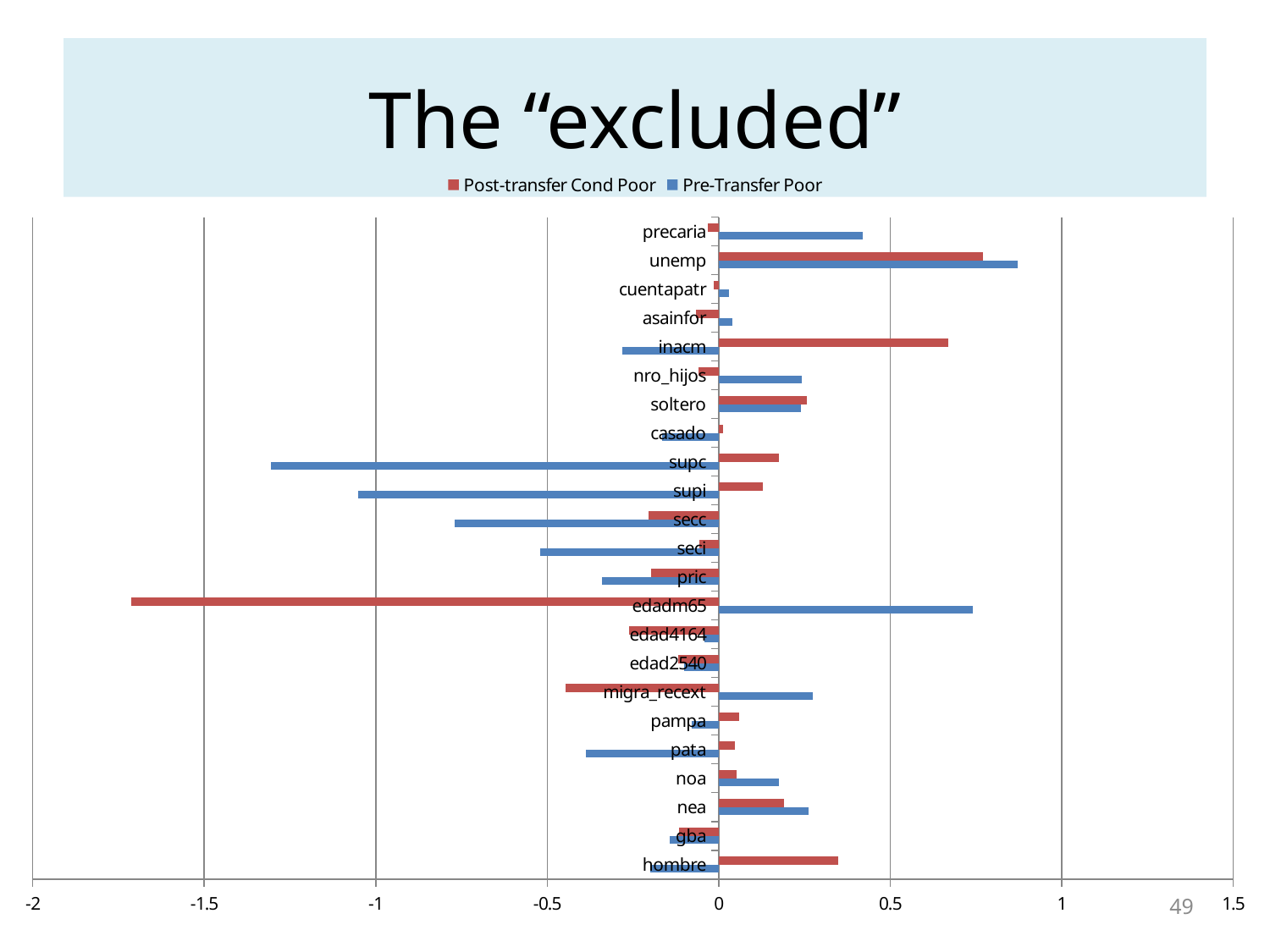
Which category has the lowest Post-transfer Cond Poor value? edadm65 Which category has the highest Pre-Transfer Poor value? unemp Which series is shown in blue according to the legend? Pre-Transfer Poor How many categories are plotted on the chart? 23 Is the Post-transfer Cond Poor value for edadm65 greater or less than -1.5? less What kind of chart is shown on the slide? Bar chart For edadm65, which series has the larger value, Post-transfer Cond Poor or Pre-Transfer Poor? Pre-Transfer Poor Is the Pre-Transfer Poor value for unemp greater or less than 0.5? greater Is the Pre-Transfer Poor value for secc greater or less than -0.5? less How many series does the legend list? 2 What is the title of the slide containing the chart? The "excluded" Which category has the lowest Pre-Transfer Poor value? supc